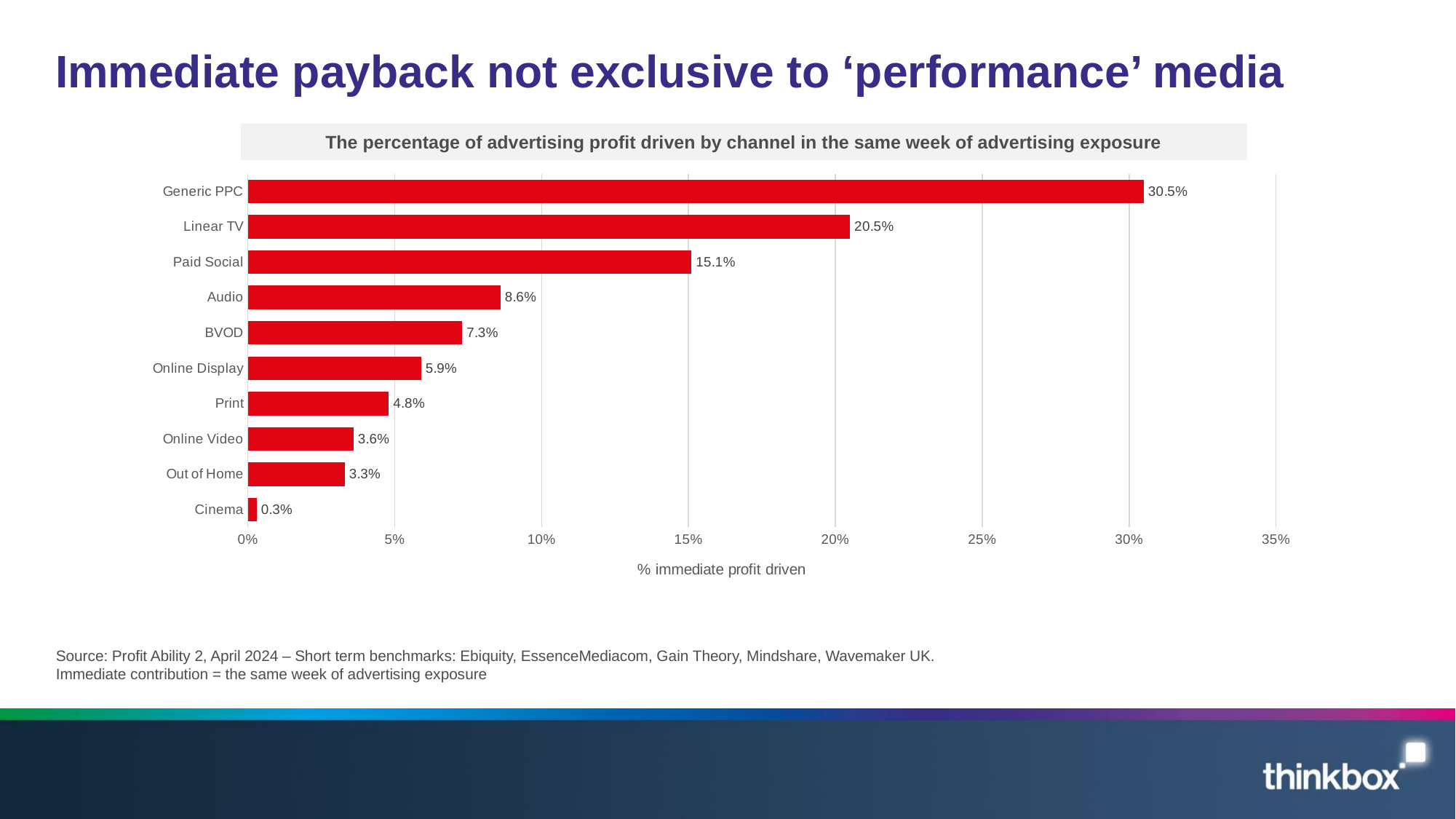
What is the difference between the values for Paid Social and BVOD? 7.8 percentage points What is the value for Out of Home? 3.3% What is the value for Audio? 8.6% Which is larger, the value for Online Display or the value for Print? Online Display What kind of chart is shown on the slide? Bar chart Which channel has the lowest percentage of immediate profit driven? Cinema How many channels are shown in the chart? 10 What is the difference between the values for Generic PPC and Linear TV? 10 percentage points Which channel has the highest percentage of immediate profit driven? Generic PPC What is the label on the horizontal axis of the chart? % immediate profit driven What is the value for Linear TV? 20.5% Is the value for Paid Social greater or less than 10%? greater